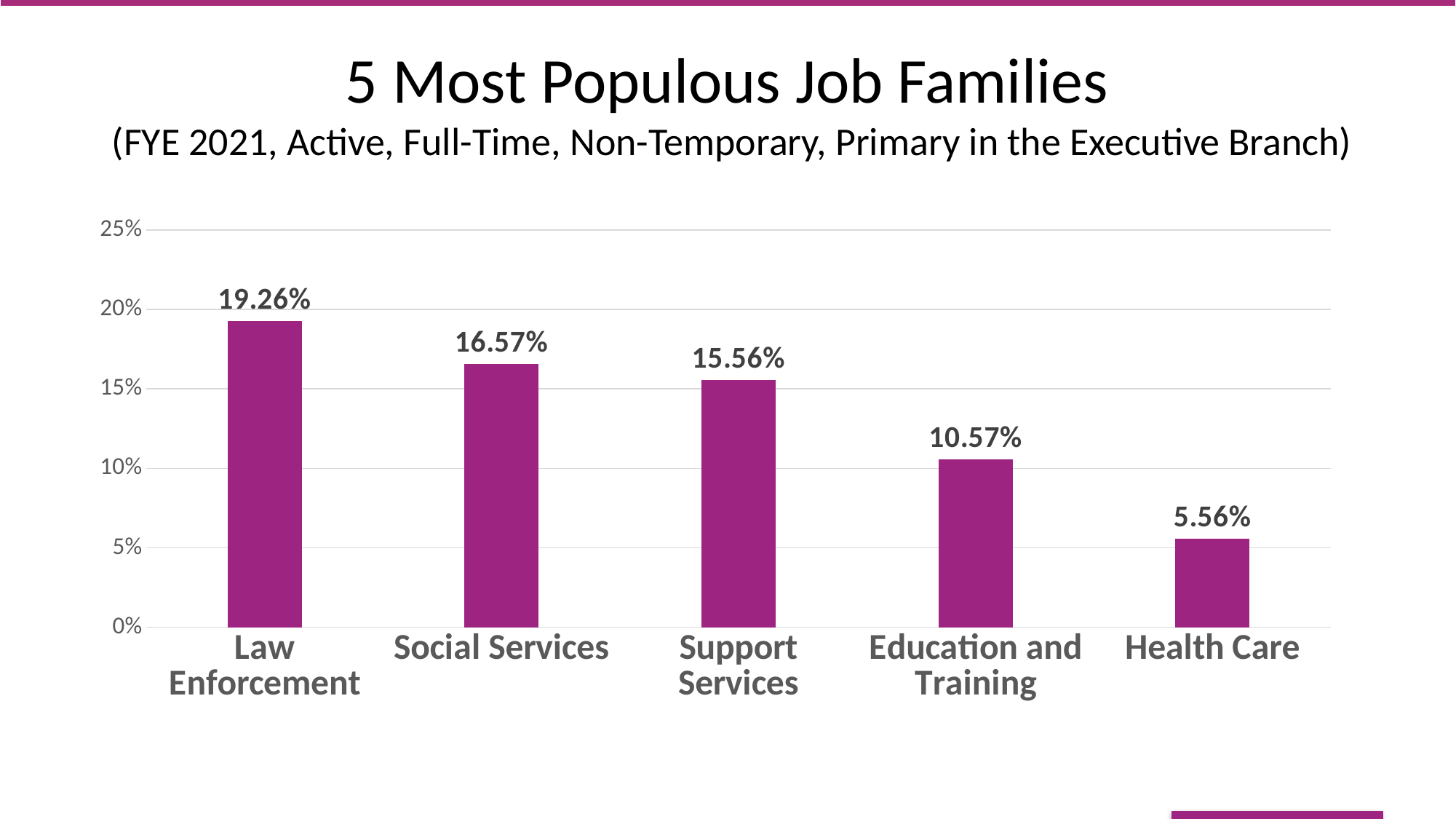
What kind of chart is shown on the slide? Bar chart What is the difference between the values for Social Services and Support Services? 1.01% How many job families are shown in the chart? 5 Which job family has the highest value? Law Enforcement Which is larger, the value for Support Services or the value for Education and Training? Support Services What is the difference between the values for Law Enforcement and Health Care? 13.70% Which job family has the lowest value? Health Care What is the value for Social Services? 16.57% What is the value for Health Care? 5.56% Do the values rise or fall from left to right across the categories? Fall What is the value for Law Enforcement? 19.26% What is the value for Education and Training? 10.57%